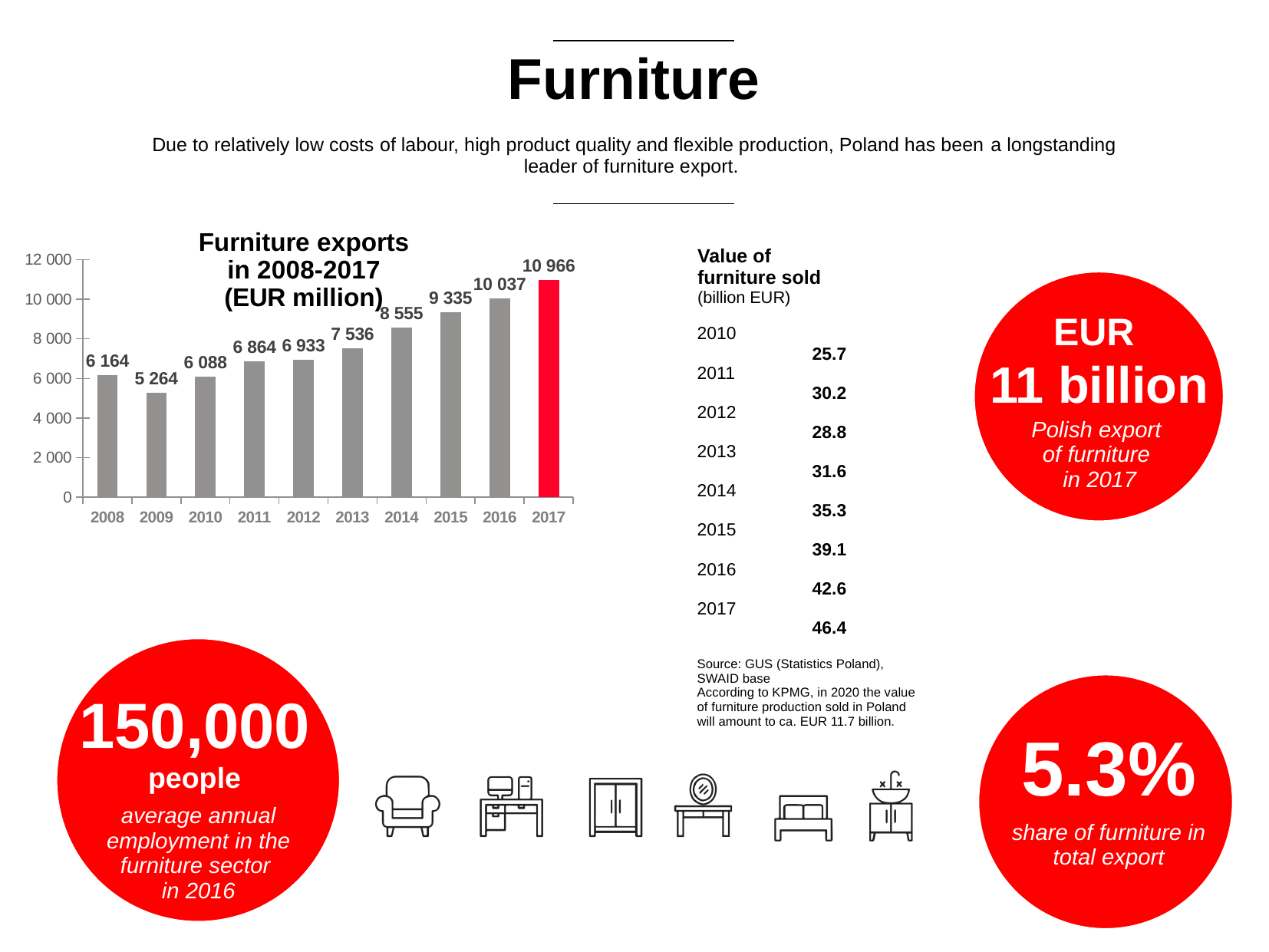
Which year has the highest furniture exports? 2017 Do furniture exports generally rise or fall from 2009 to 2017? rise What kind of chart is used to show furniture exports? bar chart What is the difference between furniture exports in 2008 and 2009? 900 What is the value of furniture exports for 2009? 5 264 Is the value for 2014 greater or less than 8 000? greater How many years are shown on the x axis of the chart? 10 What is the value of furniture exports for 2013? 7 536 What is the difference between furniture exports in 2017 and 2016? 929 Which year has higher furniture exports, 2010 or 2011? 2011 Which year has the lowest furniture exports? 2009 What is the value of furniture exports for 2017? 10 966